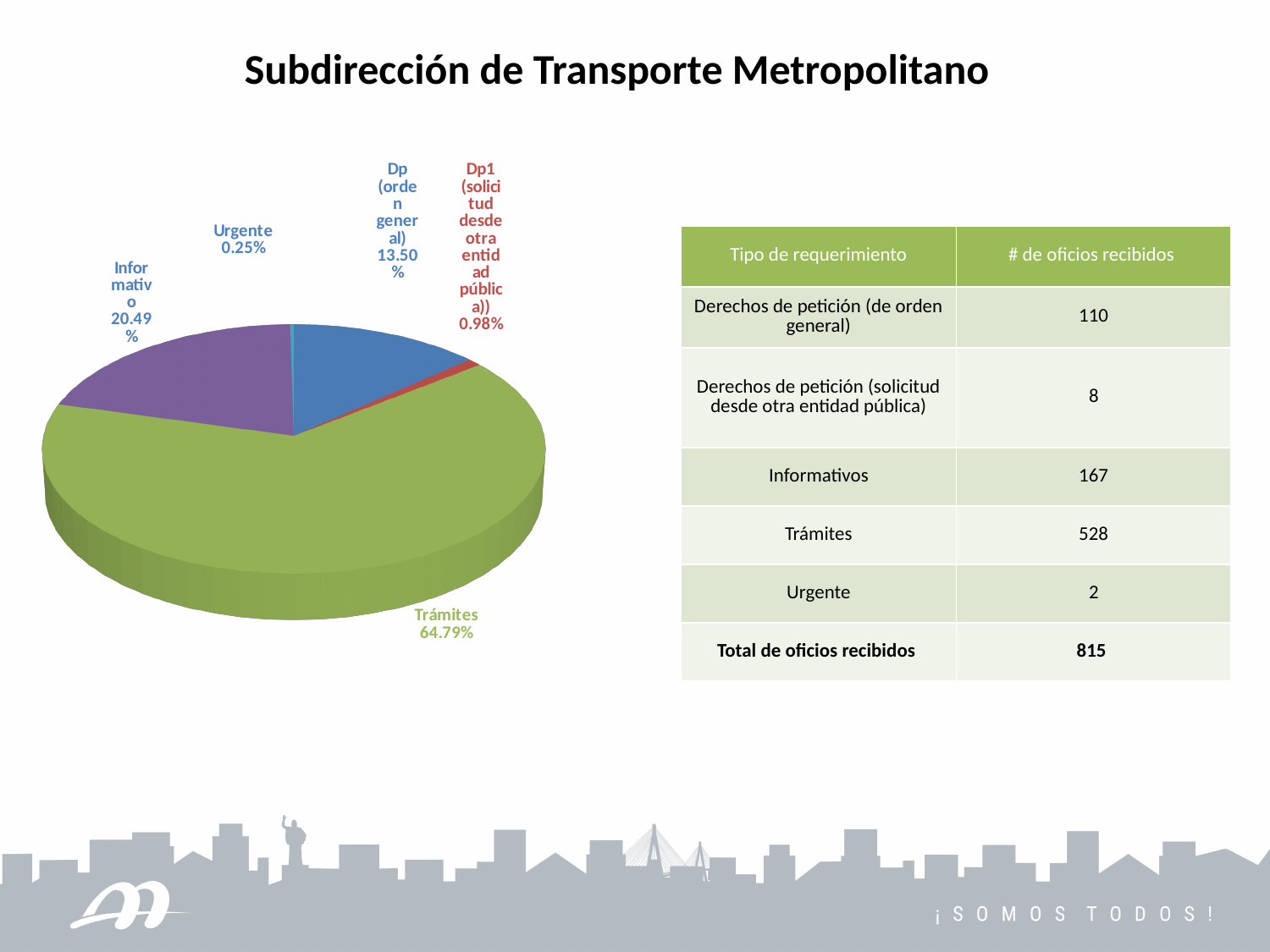
What type of chart is shown on the slide? pie chart What percentage does the Dp1 (solicitud desde otra entidad pública) slice represent in the pie chart? 0.98% What percentage does the Informativo slice represent in the pie chart? 20.49% What percentage does the Trámites slice represent in the pie chart? 64.79% What colour is the Trámites slice in the pie chart? green What is the difference in percentage points between the Trámites slice and the Informativo slice? 44.30% Which slice of the pie chart is the largest? Trámites How many slices does the pie chart have? 5 What percentage does the Dp (orden general) slice represent in the pie chart? 13.50% What percentage does the Urgente slice represent in the pie chart? 0.25% Which slice of the pie chart is the smallest? Urgente Which is larger in the pie chart, Informativo or Dp (orden general)? Informativo